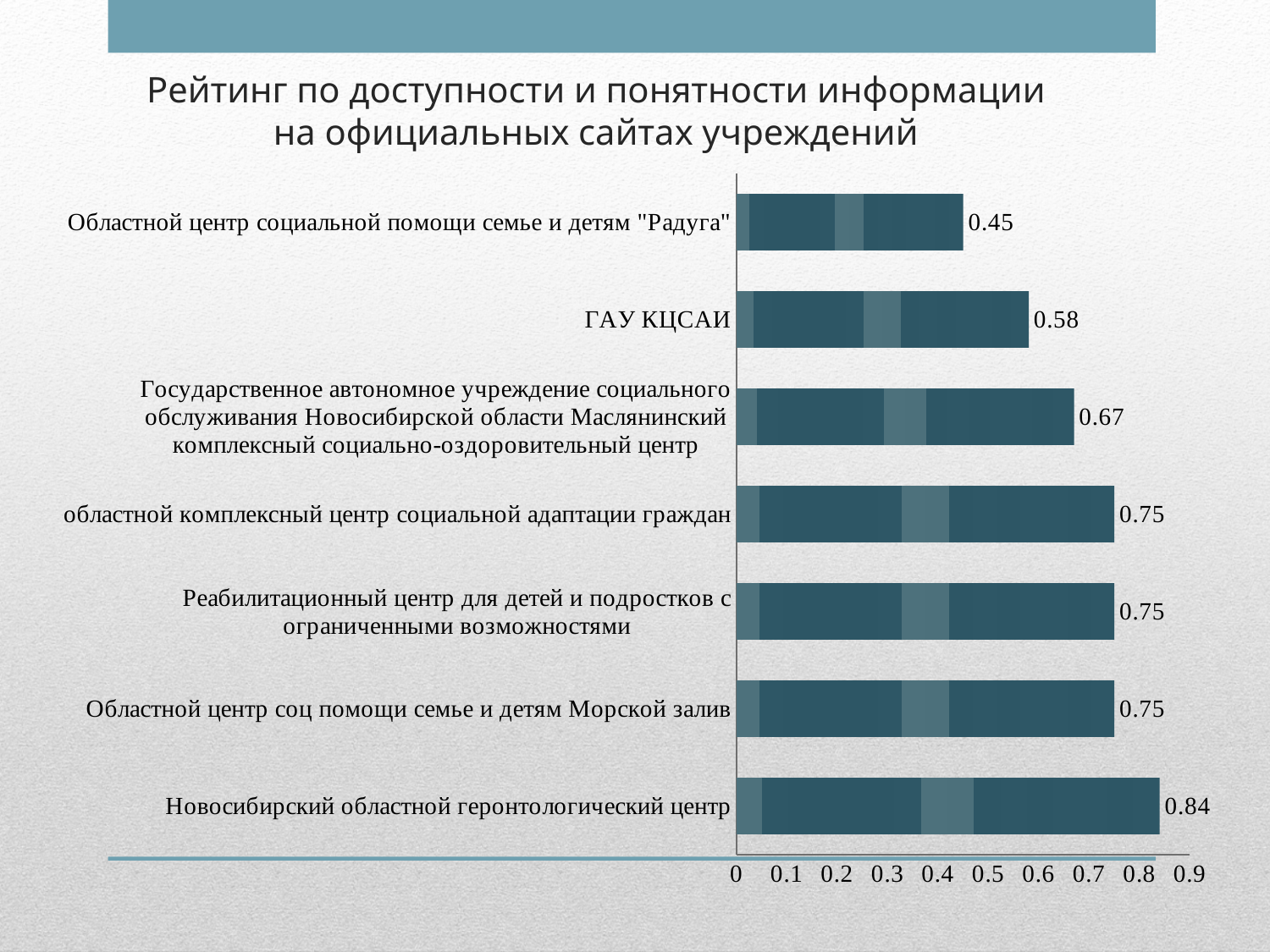
How many institutions are shown in the chart? 7 Which is larger: the value for ГАУ КЦСАИ or the value for областной комплексный центр социальной адаптации граждан? областной комплексный центр социальной адаптации граждан What is the value for ГАУ КЦСАИ? 0.58 What kind of chart is shown on the slide? bar chart What is the value for Новосибирский областной геронтологический центр? 0.84 How many institutions have a value of 0.75? 3 What is the value for Областной центр социальной помощи семье и детям "Радуга"? 0.45 What is the difference between the value for Новосибирский областной геронтологический центр and the value for ГАУ КЦСАИ? 0.26 Which institution has the lowest rating? Областной центр социальной помощи семье и детям "Радуга" What is the value for Областной центр соц помощи семье и детям Морской залив? 0.75 Which institution has the highest rating? Новосибирский областной геронтологический центр What is the title of the slide? Рейтинг по доступности и понятности информации на официальных сайтах учреждений